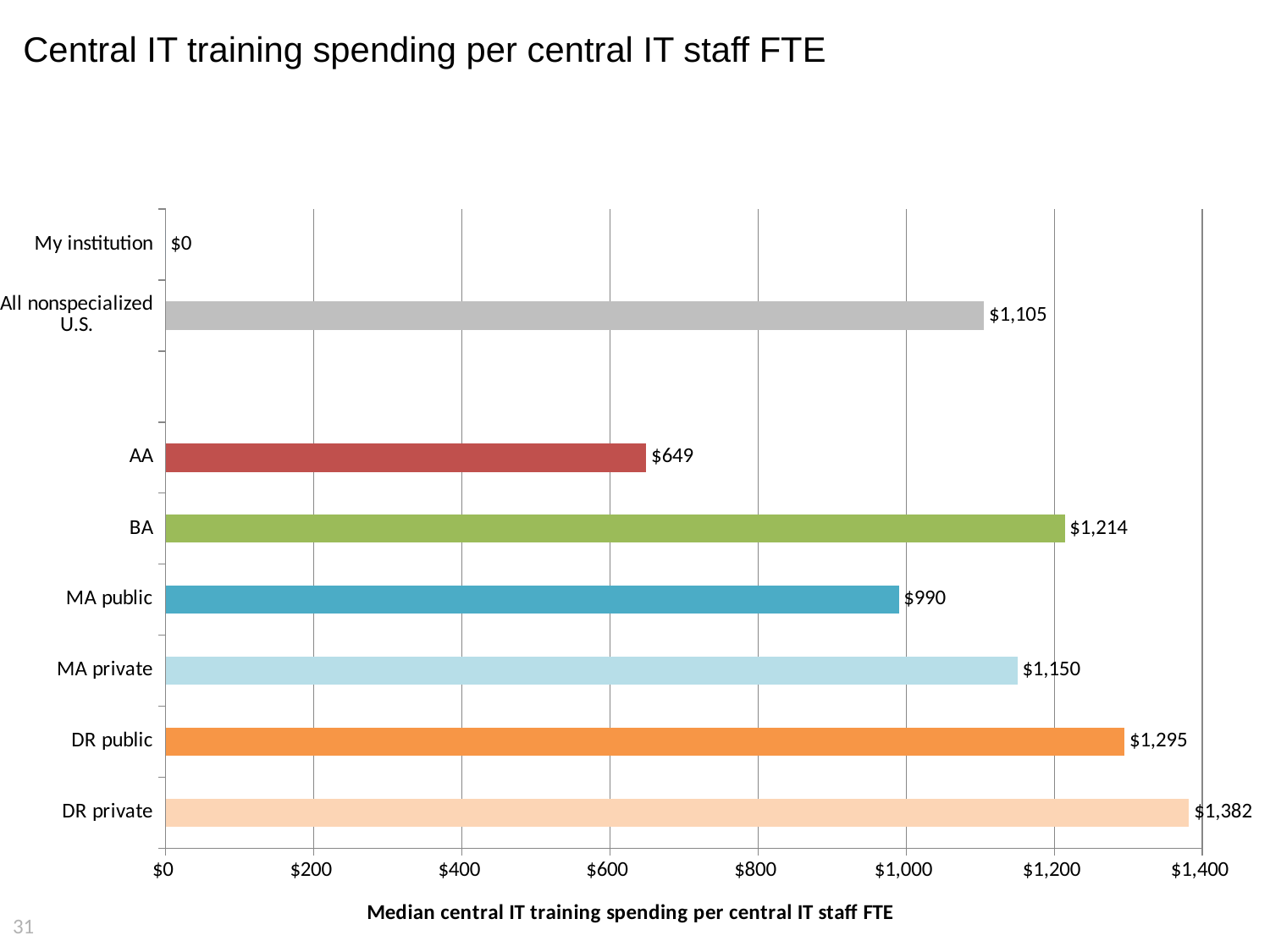
Excluding My institution, which category has the lowest value? AA What kind of chart is shown on the slide? bar chart What is the difference between DR public and MA public? $305 Which category has the highest value? DR private What is the x-axis title of the chart? Median central IT training spending per central IT staff FTE What is the value for DR private? $1,382 Is the value for MA public greater or less than $1,000? less What is the value for My institution? $0 Which is larger, BA or MA private? BA What is the value for All nonspecialized U.S.? $1,105 What is the value for AA? $649 How many labeled categories are shown on the chart? 8